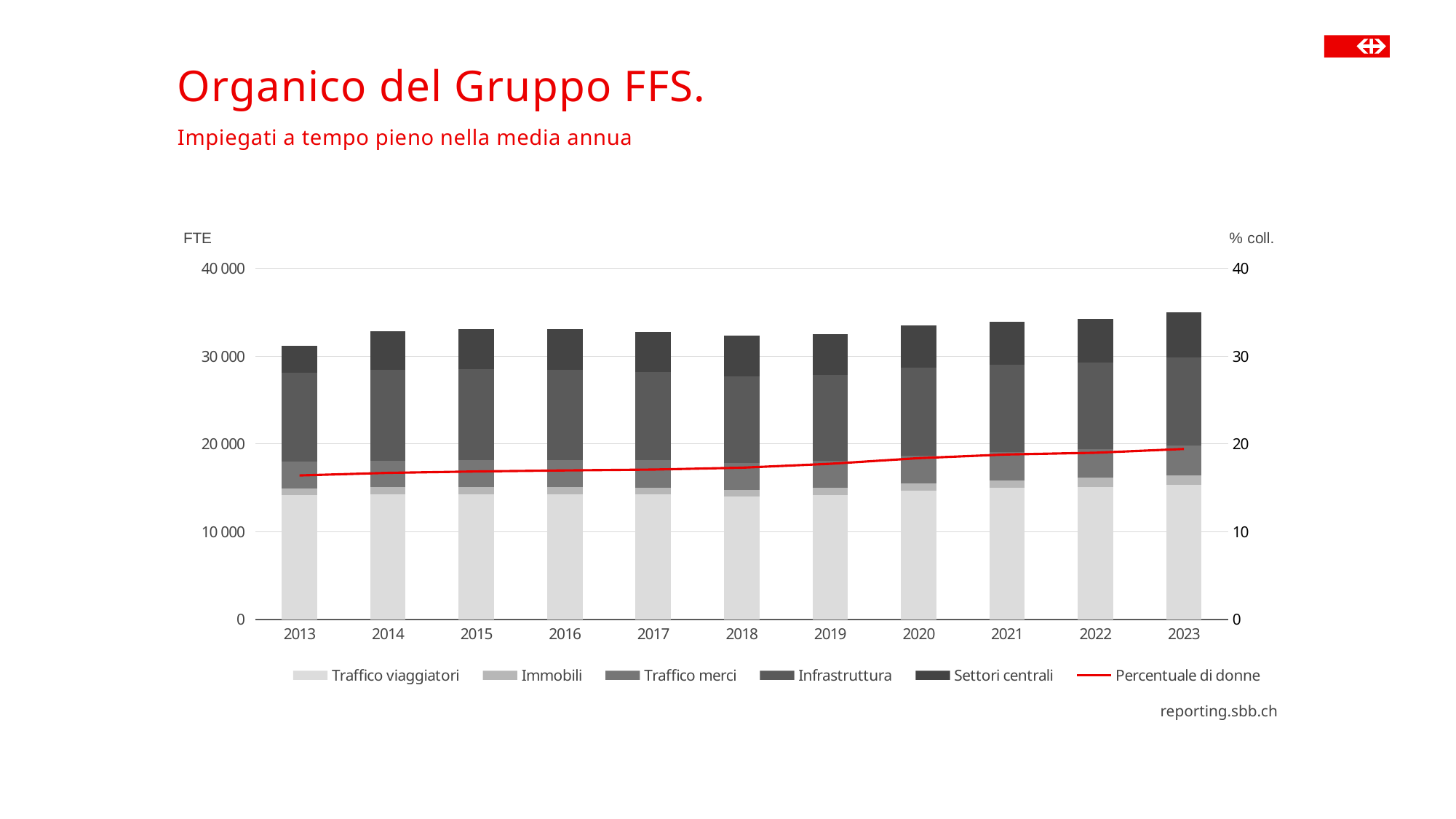
Does the Percentuale di donne line rise or fall from 2013 to 2023? rise How many years are shown on the x axis of the chart? 11 Is the Percentuale di donne value for 2013 greater or less than 20 on the right axis? less What is the label of the left vertical axis? FTE Which is larger in 2023, the Traffico viaggiatori segment or the Settori centrali segment? Traffico viaggiatori Which year has the lowest total stacked bar? 2013 What is the title of the chart slide? Organico del Gruppo FFS. How many series does the chart legend list? 6 Which year has the highest total stacked bar? 2023 Is the total stacked bar for 2023 greater or less than 30 000 FTE? greater Is the Traffico viaggiatori value for 2013 greater or less than 20 000 FTE? less What kind of chart is shown on the slide? Stacked bar chart with a line